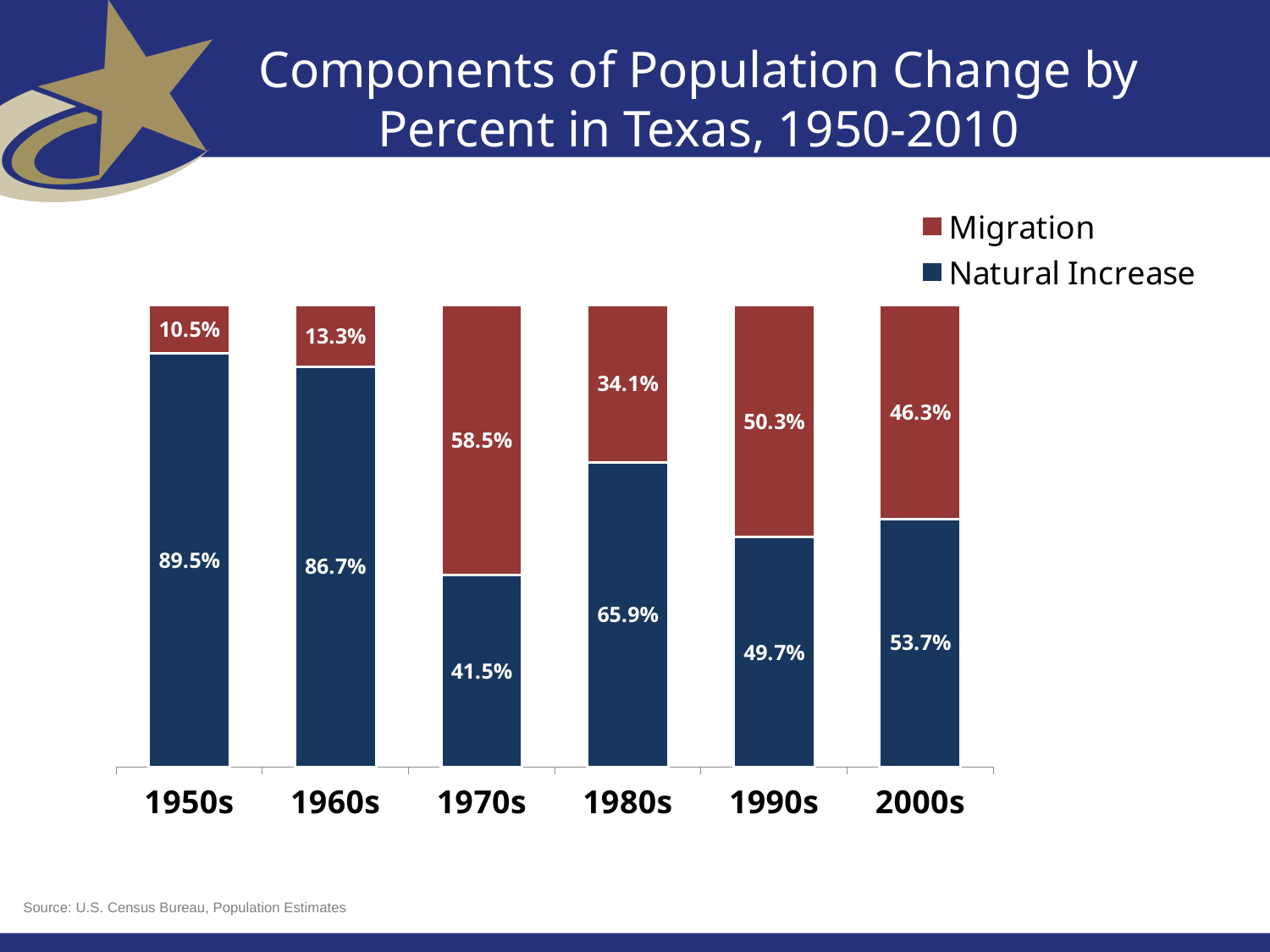
What kind of chart is shown on the slide? Stacked bar chart Which decade has the highest Migration value? 1970s What is the Natural Increase value for the 2000s? 53.7% Which is larger, the Migration value for the 1980s or the Migration value for the 2000s? 2000s What is the Natural Increase value for the 1950s? 89.5% What is the Migration value for the 1970s? 58.5% What is the total of the stacked bar for the 1980s? 100% How many series does the legend list? 2 What is the difference between the Natural Increase values for the 1950s and the 1960s? 2.8% Which decade has the lowest Natural Increase value? 1970s What is the Migration value for the 1990s? 50.3% How many decades are shown on the x axis? 6